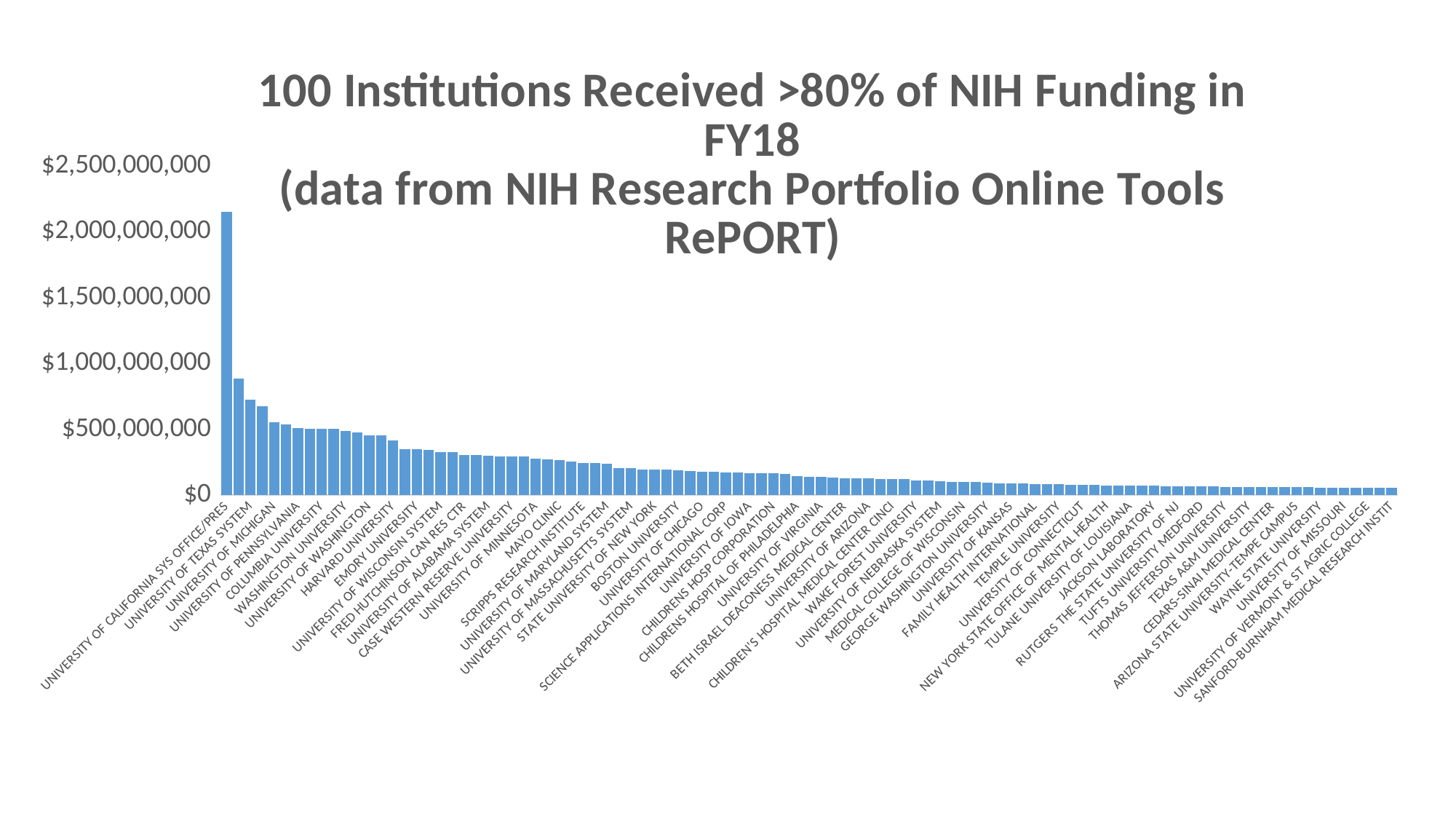
Which received more NIH funding, UNIVERSITY OF CALIFORNIA SYS OFFICE/PRES or UNIVERSITY OF TEXAS SYSTEM? UNIVERSITY OF CALIFORNIA SYS OFFICE/PRES Is the value for UNIVERSITY OF CALIFORNIA SYS OFFICE/PRES greater or less than $2,000,000,000? greater Which received more NIH funding, HARVARD UNIVERSITY or MAYO CLINIC? HARVARD UNIVERSITY Is the value for UNIVERSITY OF TEXAS SYSTEM greater or less than $1,000,000,000? less Which received more NIH funding, UNIVERSITY OF TEXAS SYSTEM or UNIVERSITY OF MICHIGAN? UNIVERSITY OF TEXAS SYSTEM Which institution received the most NIH funding in FY18 according to the chart? UNIVERSITY OF CALIFORNIA SYS OFFICE/PRES What is the highest value shown on the vertical axis? $2,500,000,000 Is the value for BOSTON UNIVERSITY greater or less than $500,000,000? less Do the bar values rise or fall from left to right along the x axis? fall What kind of chart is shown on the slide? bar chart According to the chart title, how many institutions are included in the chart? 100